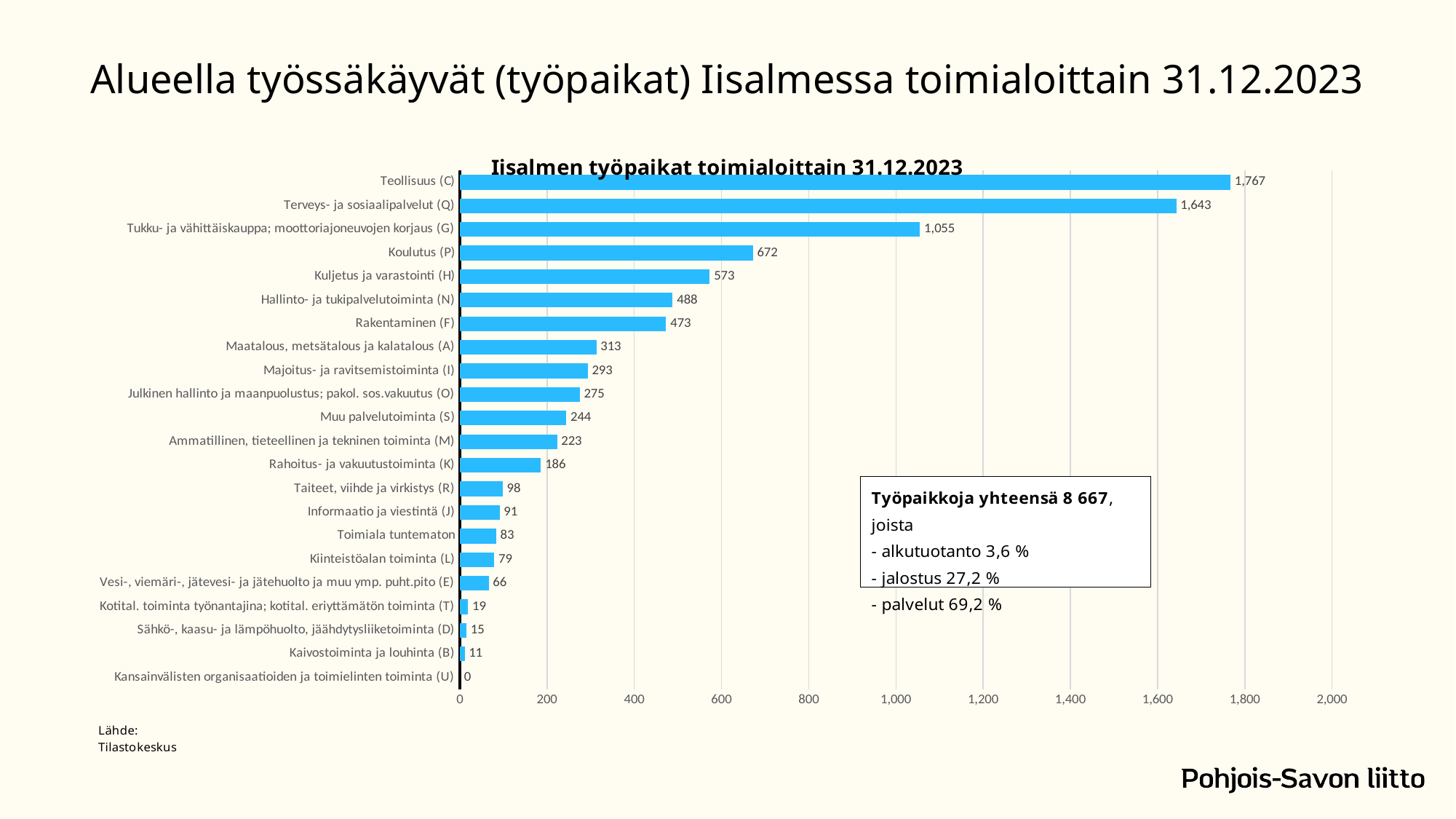
What type of chart is shown on the slide? bar chart What is the value for Teollisuus (C)? 1,767 Which is larger, the value for Rakentaminen (F) or the value for Maatalous, metsätalous ja kalatalous (A)? Rakentaminen (F) What is the value for Koulutus (P)? 672 Which category has the lowest value? Kansainvälisten organisaatioiden ja toimielinten toiminta (U) What is the difference between the values for Koulutus (P) and Kuljetus ja varastointi (H)? 99 How many categories are shown in the chart? 22 What is the value for Kaivostoiminta ja louhinta (B)? 11 Which category has the highest value? Teollisuus (C) What is the value for Rahoitus- ja vakuutustoiminta (K)? 186 What is the title of the chart? Iisalmen työpaikat toimialoittain 31.12.2023 What is the difference between the values for Teollisuus (C) and Terveys- ja sosiaalipalvelut (Q)? 124